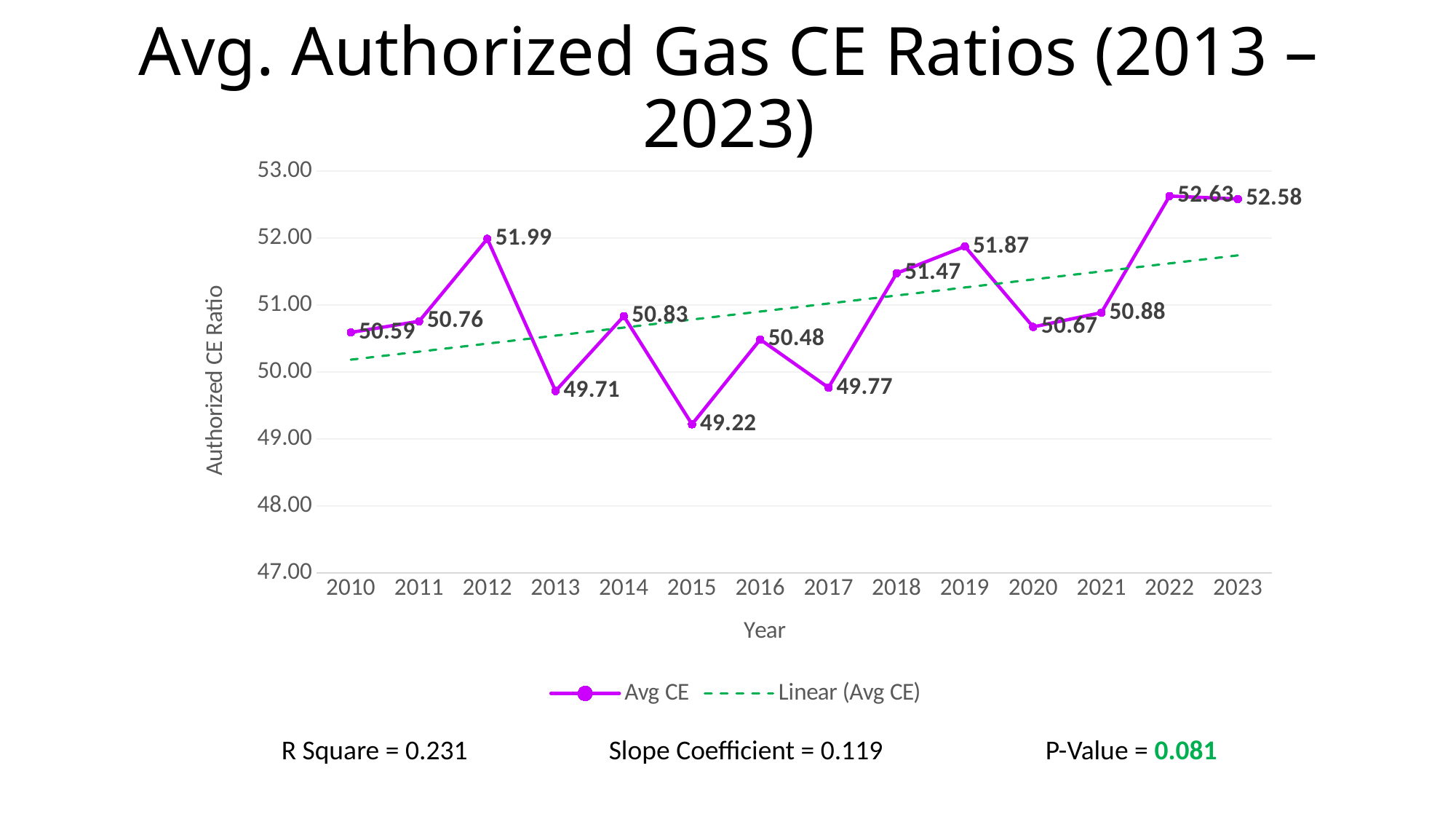
Which year has the highest Avg CE value according to the data labels? 2022 How many series does the legend list? 2 What kind of chart is shown on the slide? line chart Is the Avg CE value for 2017 greater or less than 50.00? less Which year has a larger Avg CE value, 2013 or 2018? 2018 How many years are plotted on the x axis? 14 What is the slope coefficient shown below the chart? 0.119 Which year has the lowest Avg CE value? 2015 What is the Avg CE value for 2012? 51.99 What is the Avg CE value for 2019? 51.87 What is the difference between the Avg CE values for 2022 and 2010? 2.04 What is the Avg CE value for 2015? 49.22